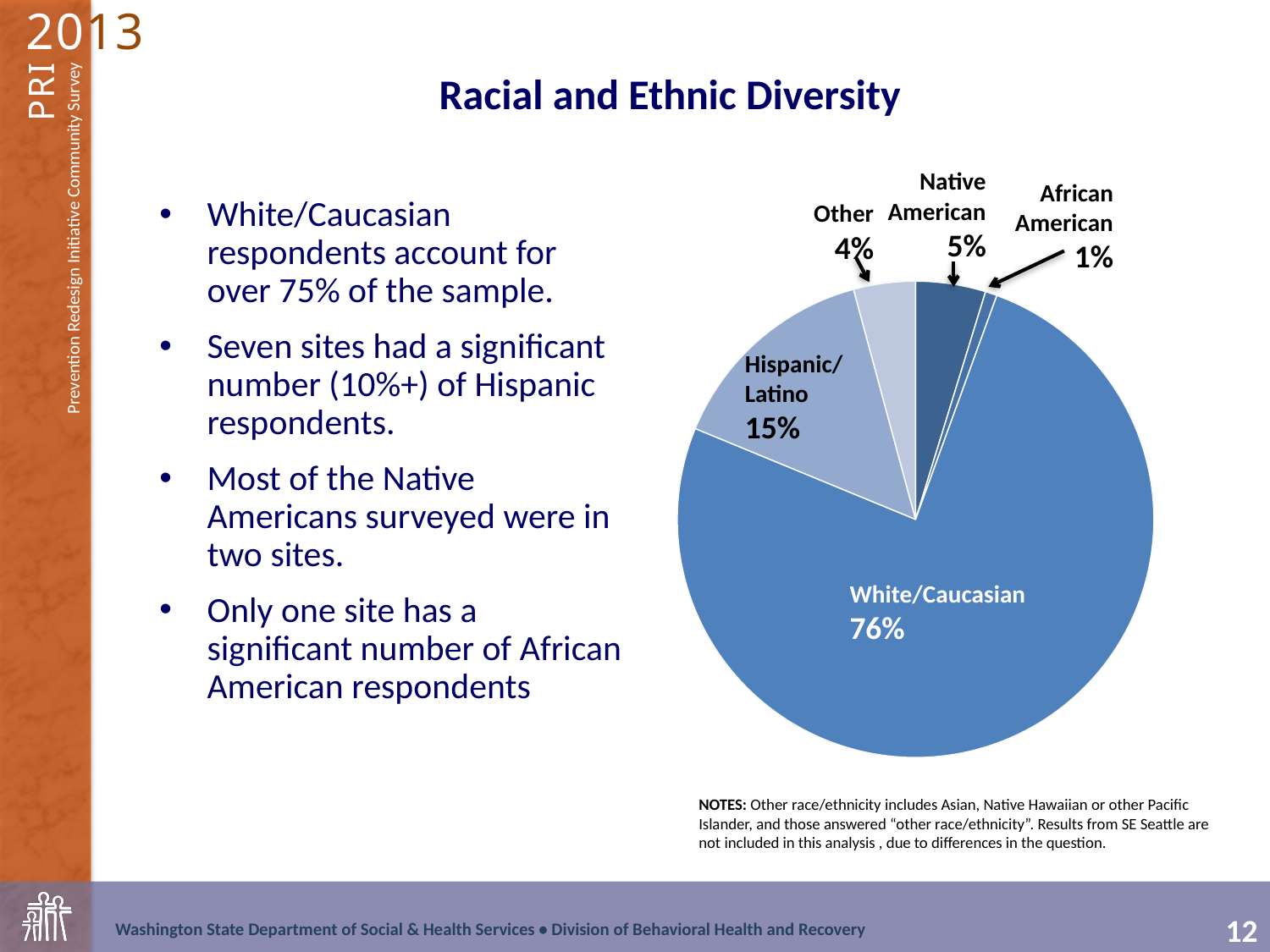
What share of respondents are Hispanic/Latino? 15% How many slices does the pie chart have? 5 What share of respondents are Native American? 5% What share of respondents are African American? 1% What share of respondents are White/Caucasian? 76% Which racial/ethnic group has the largest slice of the pie? White/Caucasian What kind of chart is shown on the slide? pie chart What share of respondents fall into the Other category? 4% Which is larger, the Native American share or the Other share? Native American What is the difference in percentage points between the White/Caucasian and Hispanic/Latino shares? 61 What is the title of the chart slide? Racial and Ethnic Diversity Which racial/ethnic group has the smallest slice of the pie? African American